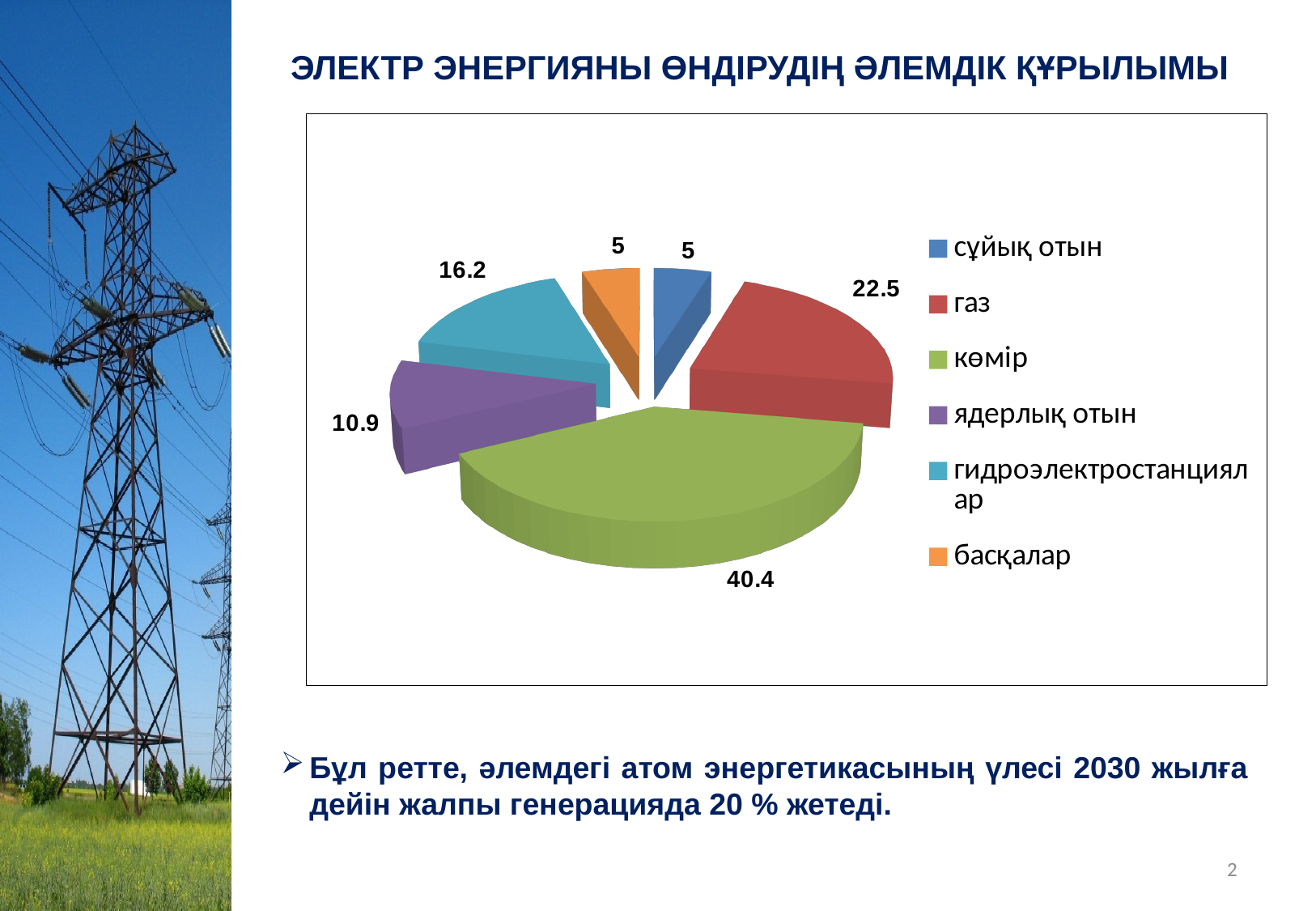
What is the value for көмір? 40.4 What colour is the slice for ядерлық отын? purple What is the value for гидроэлектростанциялар? 16.2 Which category has the largest slice of the pie? көмір How many categories does the pie chart have? 6 Which two categories share the same value of 5? сұйық отын and басқалар What is the value for газ? 22.5 What is the difference between the values for гидроэлектростанциялар and ядерлық отын? 5.3 What is the difference between the values for көмір and газ? 17.9 What kind of chart is shown on the slide? pie chart What is the value for ядерлық отын? 10.9 Which category is larger, газ or ядерлық отын? газ